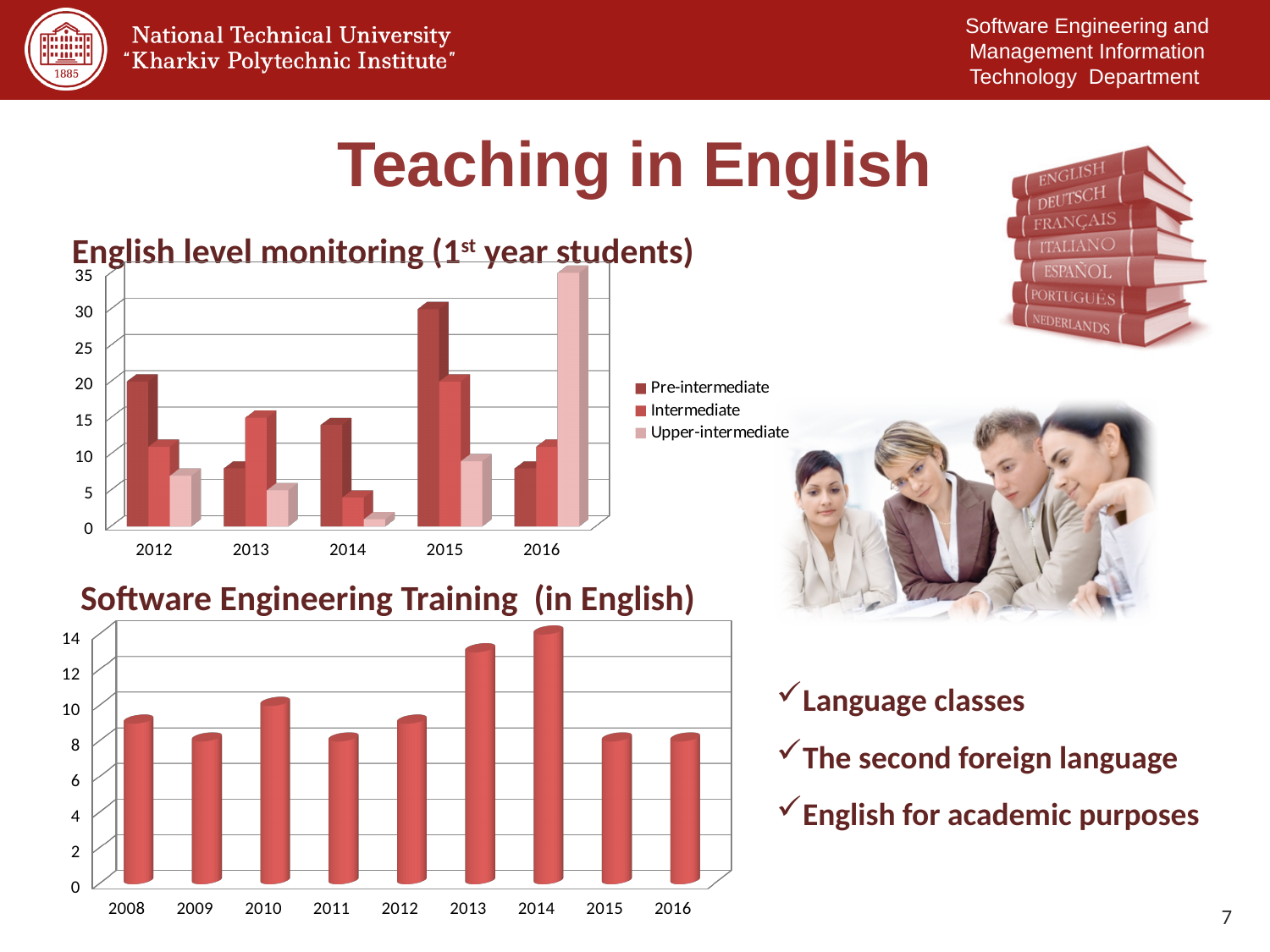
In the "English level monitoring (1st year students)" chart, which year has the highest Pre-intermediate value? 2015 How many years are shown on the x axis of the "English level monitoring (1st year students)" chart? 5 How many series does the legend of the "English level monitoring (1st year students)" chart list? 3 In the "Software Engineering Training (in English)" chart, which year has the highest value? 2014 In the "English level monitoring (1st year students)" chart, which year has the lowest Upper-intermediate value? 2014 In the "English level monitoring (1st year students)" chart, is the Intermediate value for 2014 greater or less than 5? less What kind of chart is the "English level monitoring (1st year students)" chart? bar chart In the "English level monitoring (1st year students)" chart, is the Pre-intermediate value for 2015 greater or less than 25? greater How many years are shown on the x axis of the "Software Engineering Training (in English)" chart? 9 In the "English level monitoring (1st year students)" chart, which is larger for 2015: Pre-intermediate or Intermediate? Pre-intermediate In the "English level monitoring (1st year students)" chart, which year has the highest Upper-intermediate value? 2016 In the "Software Engineering Training (in English)" chart, is the value for 2013 greater or less than 12? greater